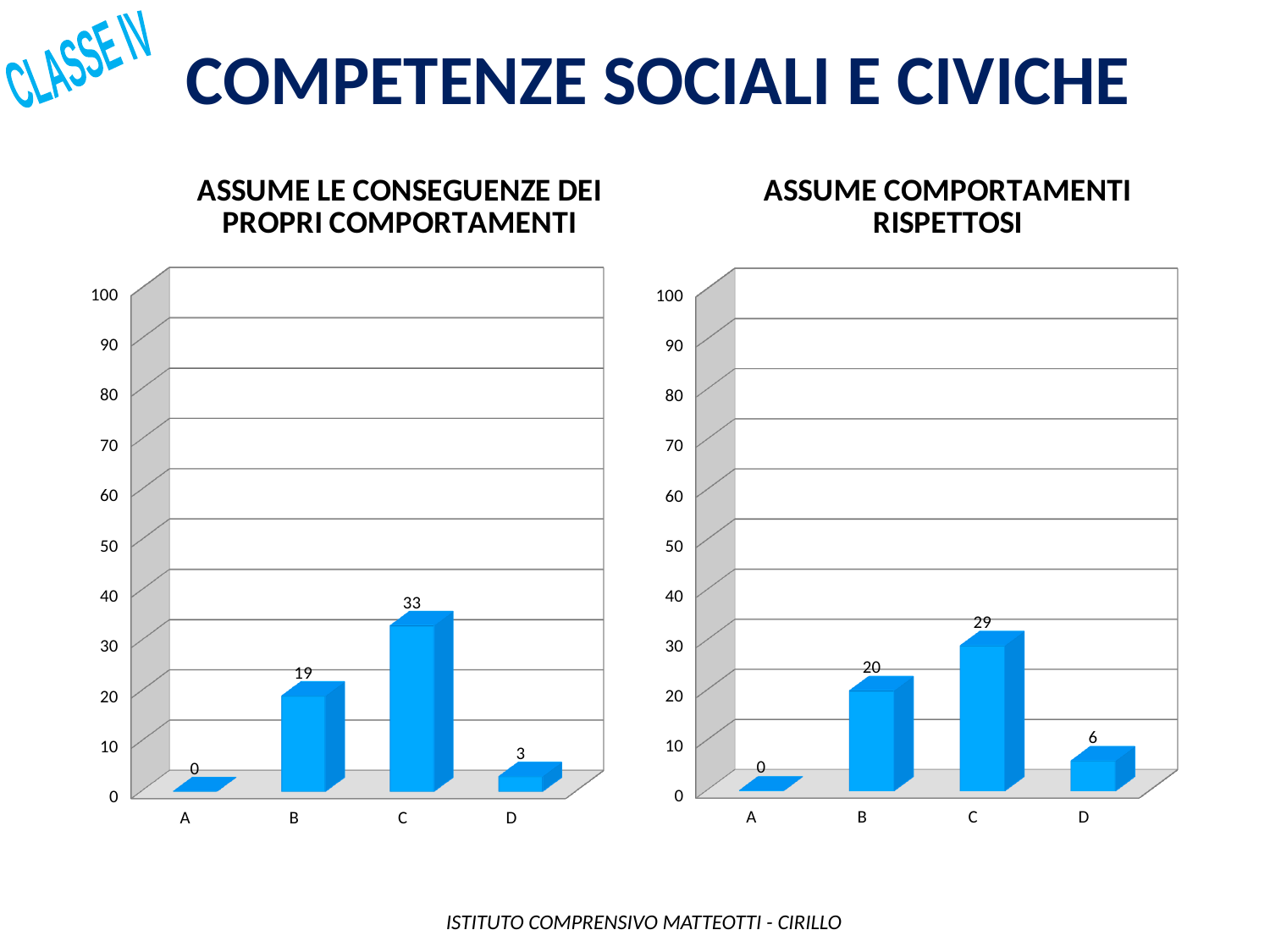
In the right chart, which category has the lowest value? A What is the title of the chart on the right side of the slide? ASSUME COMPORTAMENTI RISPETTOSI In the chart titled "ASSUME COMPORTAMENTI RISPETTOSI", what is the difference between the values for C and D? 23 In the chart titled "ASSUME LE CONSEGUENZE DEI PROPRI COMPORTAMENTI", what is the value for category C? 33 What kind of chart is the chart titled "ASSUME COMPORTAMENTI RISPETTOSI"? bar chart How many categories are shown on the x axis of the left chart? 4 In the left chart, what is the value for category D? 3 In the chart titled "ASSUME COMPORTAMENTI RISPETTOSI", what is the value for category B? 20 In the left chart, which category has the highest value? C In the right chart, which is larger, the value for B or the value for D? B In the chart titled "ASSUME LE CONSEGUENZE DEI PROPRI COMPORTAMENTI", what is the difference between the values for C and B? 14 In the left chart, is the value for C greater or less than 30? greater